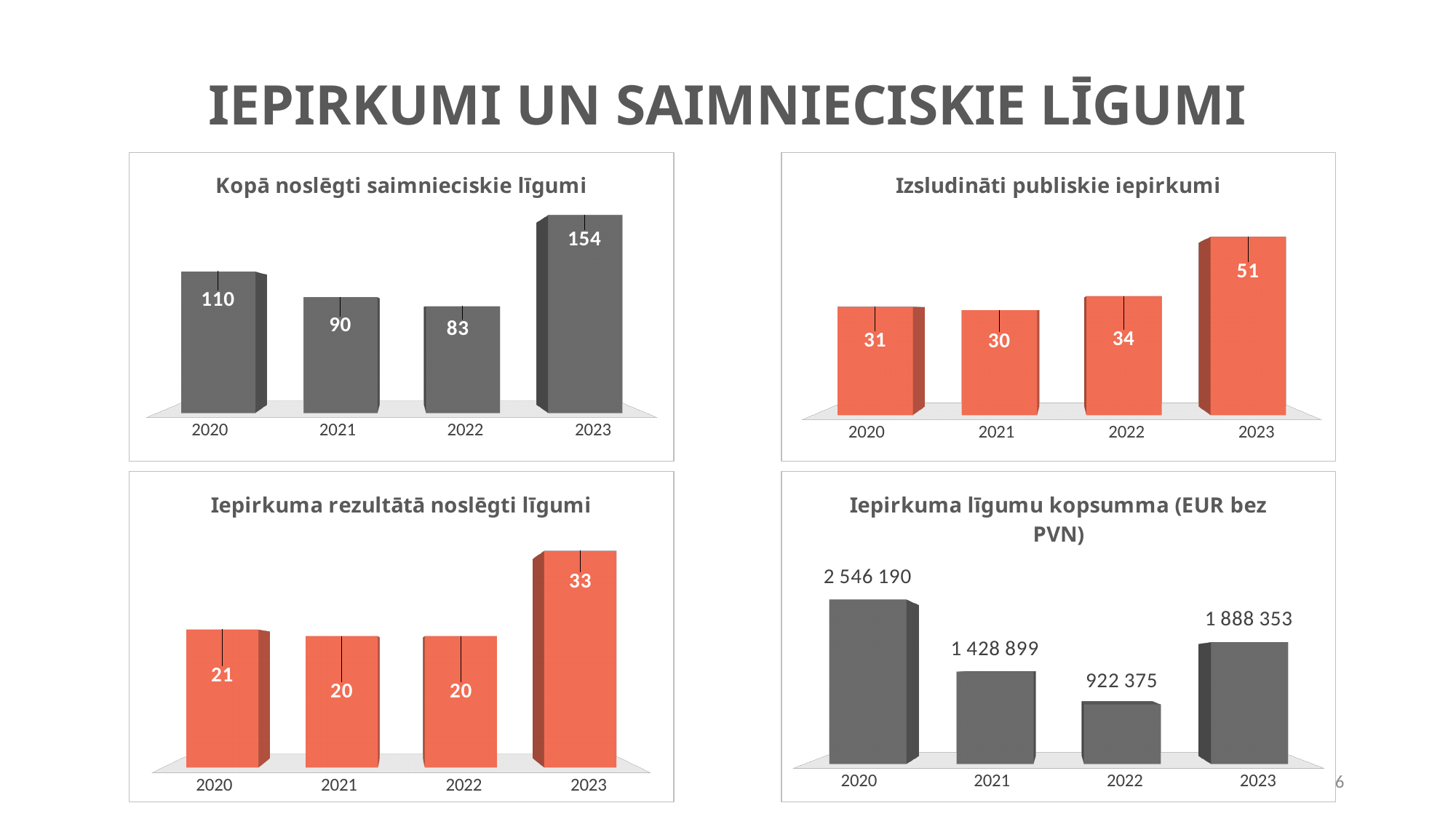
In the chart titled "Izsludināti publiskie iepirkumi", what is the value for 2022? 34 In the chart titled "Kopā noslēgti saimnieciskie līgumi", which year has the lowest value? 2022 In the chart titled "Izsludināti publiskie iepirkumi", which year has the highest value? 2023 In the chart titled "Kopā noslēgti saimnieciskie līgumi", what is the difference between the values for 2023 and 2020? 44 In the chart titled "Iepirkuma līgumu kopsumma (EUR bez PVN)", which year has the lowest value? 2022 In the chart titled "Iepirkuma līgumu kopsumma (EUR bez PVN)", what is the value for 2020? 2 546 190 What kind of chart is the chart titled "Iepirkuma rezultātā noslēgti līgumi"? bar chart In the chart titled "Iepirkuma rezultātā noslēgti līgumi", what is the value for 2020? 21 In the chart titled "Iepirkuma rezultātā noslēgti līgumi", what is the difference between the values for 2023 and 2021? 13 In the chart titled "Kopā noslēgti saimnieciskie līgumi", what is the value for 2023? 154 In the chart titled "Izsludināti publiskie iepirkumi", how many years are shown on the x axis? 4 In the chart titled "Iepirkuma līgumu kopsumma (EUR bez PVN)", which is larger, the value for 2021 or the value for 2023? 2023